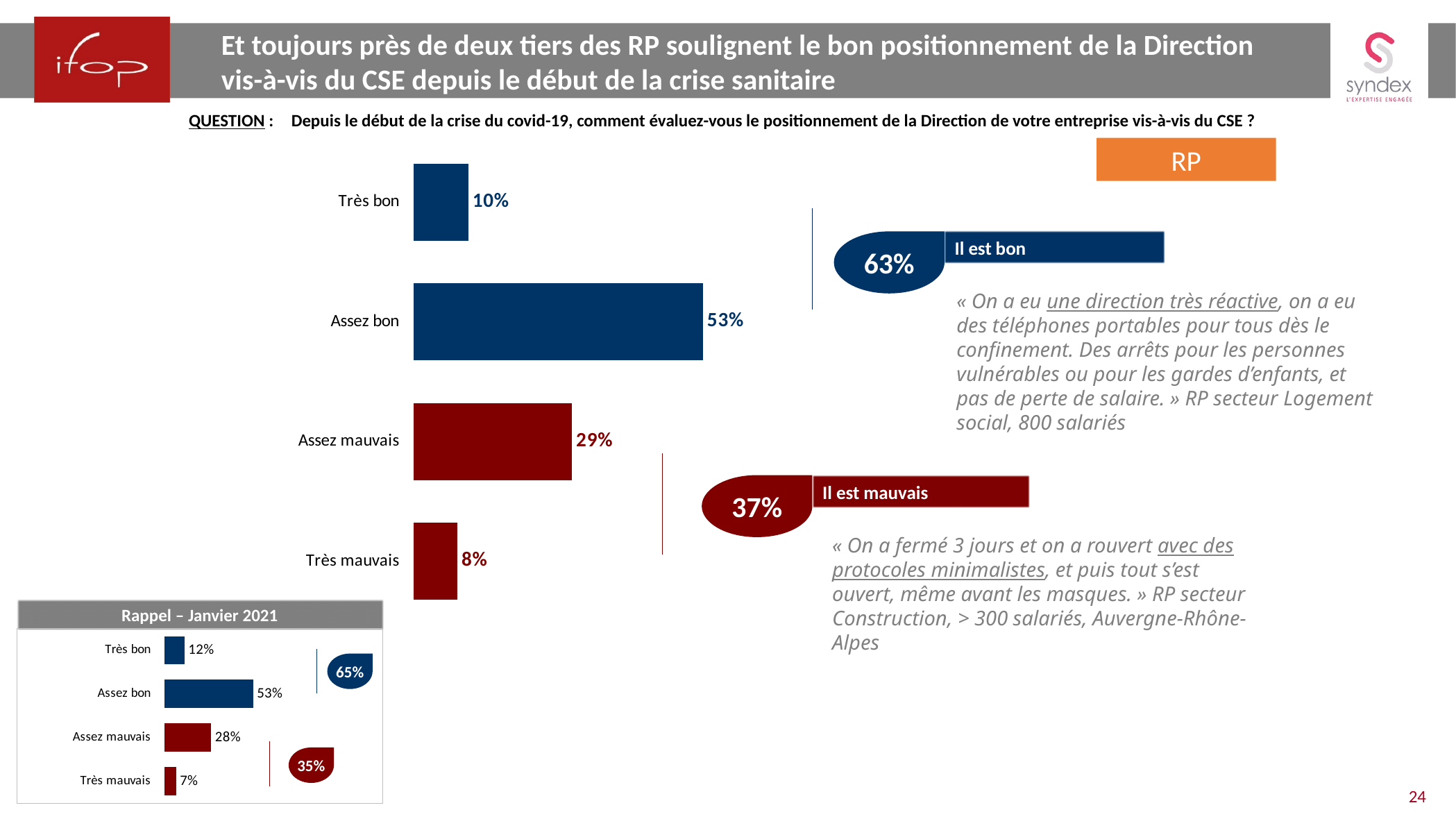
In the main chart, which category has the highest value? Assez bon How many categories does the main chart show? 4 In the main chart, which is larger, "Très bon" or "Très mauvais"? Très bon What kind of chart is the main chart? Bar chart In the main chart, what is the value for "Très mauvais"? 8% In the main chart, what is the difference between "Assez bon" and "Assez mauvais"? 24% In the "Rappel – Janvier 2021" chart, what is the value for "Assez mauvais"? 28% In the main chart, what combined share is shown for "Il est bon"? 63% In the main chart, what is the value for "Assez bon"? 53% In the "Rappel – Janvier 2021" chart, what combined share is shown for the two "mauvais" categories? 35% In the "Rappel – Janvier 2021" chart, what is the value for "Très bon"? 12% In the main chart, which category has the lowest value? Très mauvais